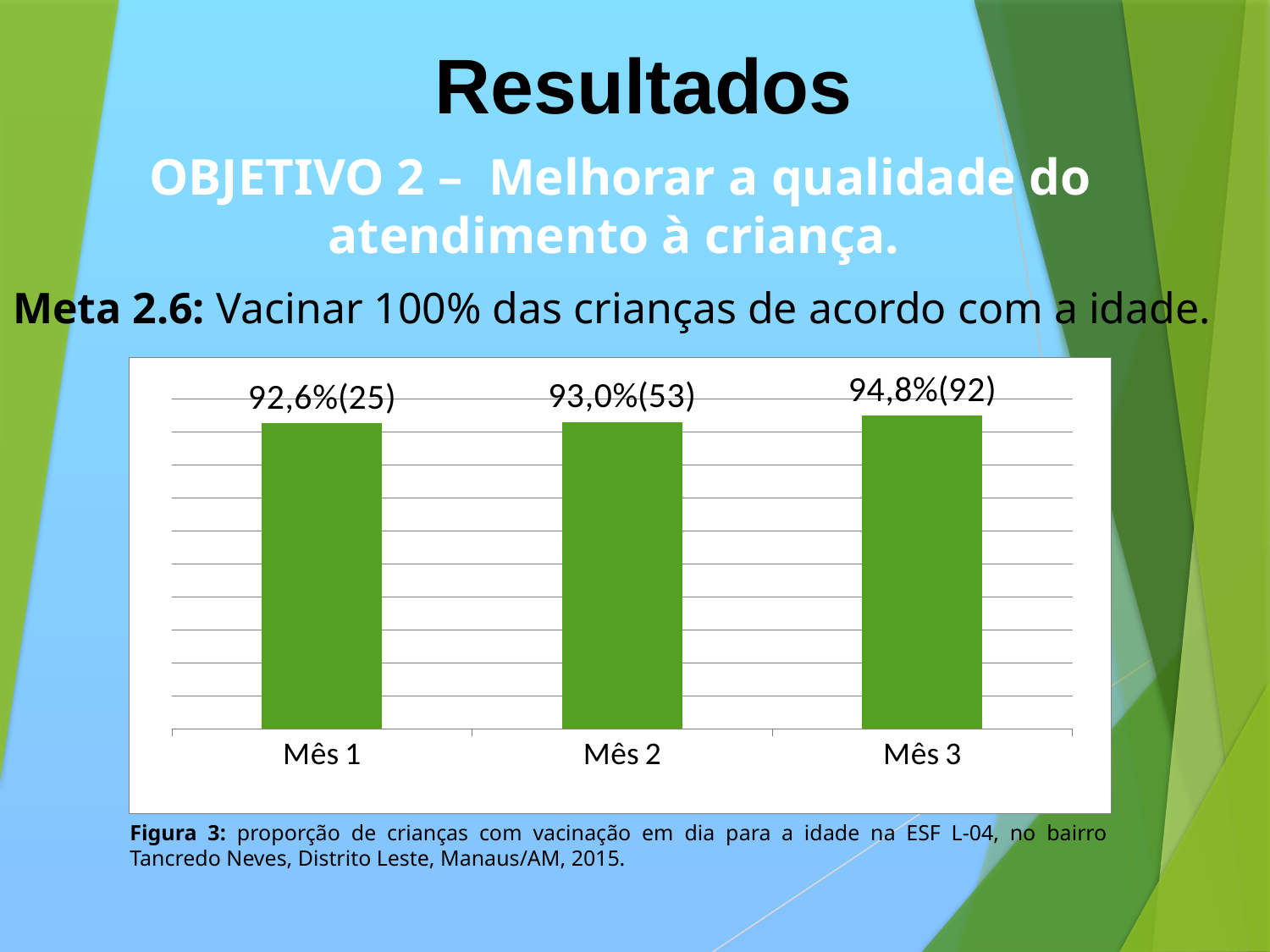
What is the data label shown for Mês 2? 93,0%(53) Which is larger, the percentage for Mês 2 or for Mês 1? Mês 2 What is the data label shown for Mês 3? 94,8%(92) Which month has the lowest percentage according to the data labels? Mês 1 Do the percentages rise or fall from Mês 1 to Mês 3? Rise What is the difference in percentage points between Mês 3 and Mês 1? 2,2 How many months (categories) are shown on the x axis? 3 What is the difference between the counts in parentheses for Mês 3 and Mês 1? 67 What percentage is shown for Mês 3? 94,8% What kind of chart is shown on the slide? Bar chart What is the data label shown for Mês 1? 92,6%(25) Which month has the highest percentage according to the data labels? Mês 3